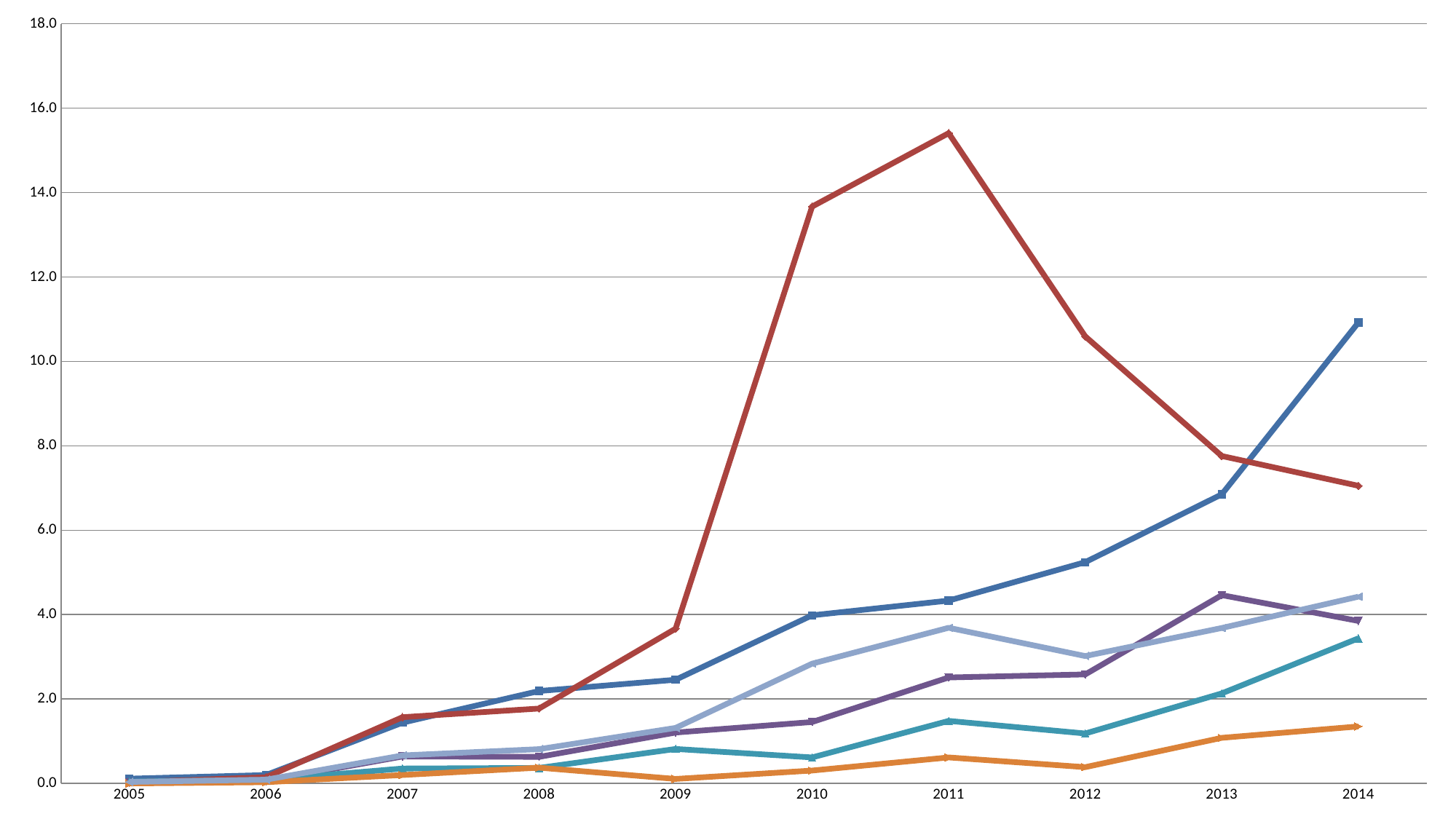
Is the value of the red line in 2014 greater or less than 8.0? less How many lines are plotted on the chart? 6 In which year does the red line reach its highest value? 2011 Is the value of the red line in 2010 greater or less than 12.0? greater Is the value of the dark blue line in 2014 greater or less than 10.0? greater How many years are shown along the x axis? 10 In 2014, which is larger: the red line or the dark blue line? the dark blue line Which line has the lowest value in 2014? the orange line In 2010, which is larger: the red line or the dark blue line? the red line Does the dark blue line rise or fall from 2005 to 2014? rise What kind of chart is shown on the slide? line chart